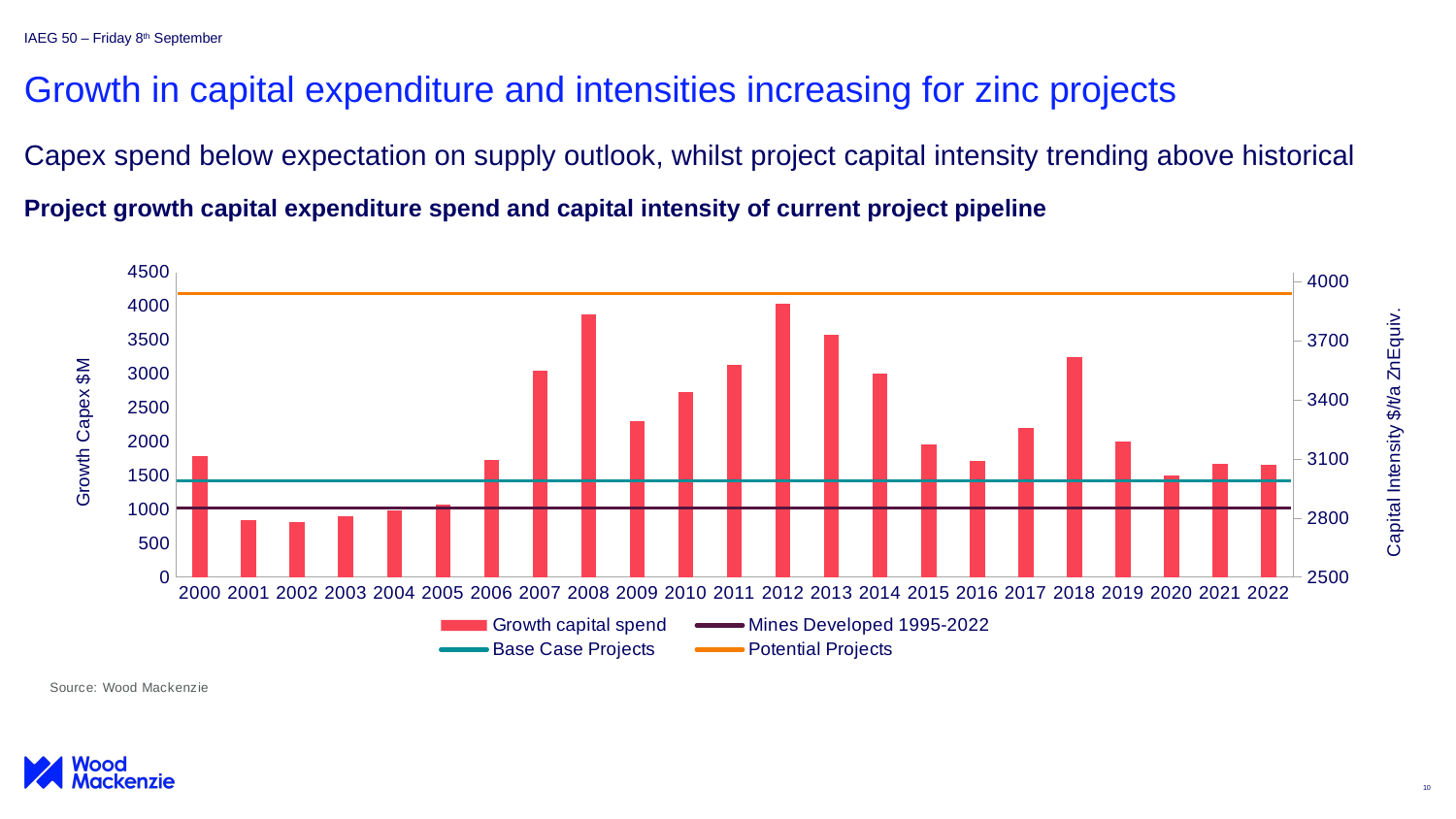
What kind of chart is used to show the growth capital spend by year? Bar chart How many years are shown on the x axis of the chart? 23 Which year has the highest growth capital spend? 2012 Is the growth capital spend for 2001 greater or less than 1000? less Is the growth capital spend for 2020 greater or less than 2000? less How many series does the chart's legend list? 4 What is the label of the right-hand vertical axis? Capital Intensity $/t/a ZnEquiv. Which year has the larger growth capital spend, 2008 or 2013? 2008 Does the growth capital spend rise or fall from 2004 to 2008? Rise Is the growth capital spend for 2012 greater or less than 3500? greater Which year has the larger growth capital spend, 2006 or 2009? 2009